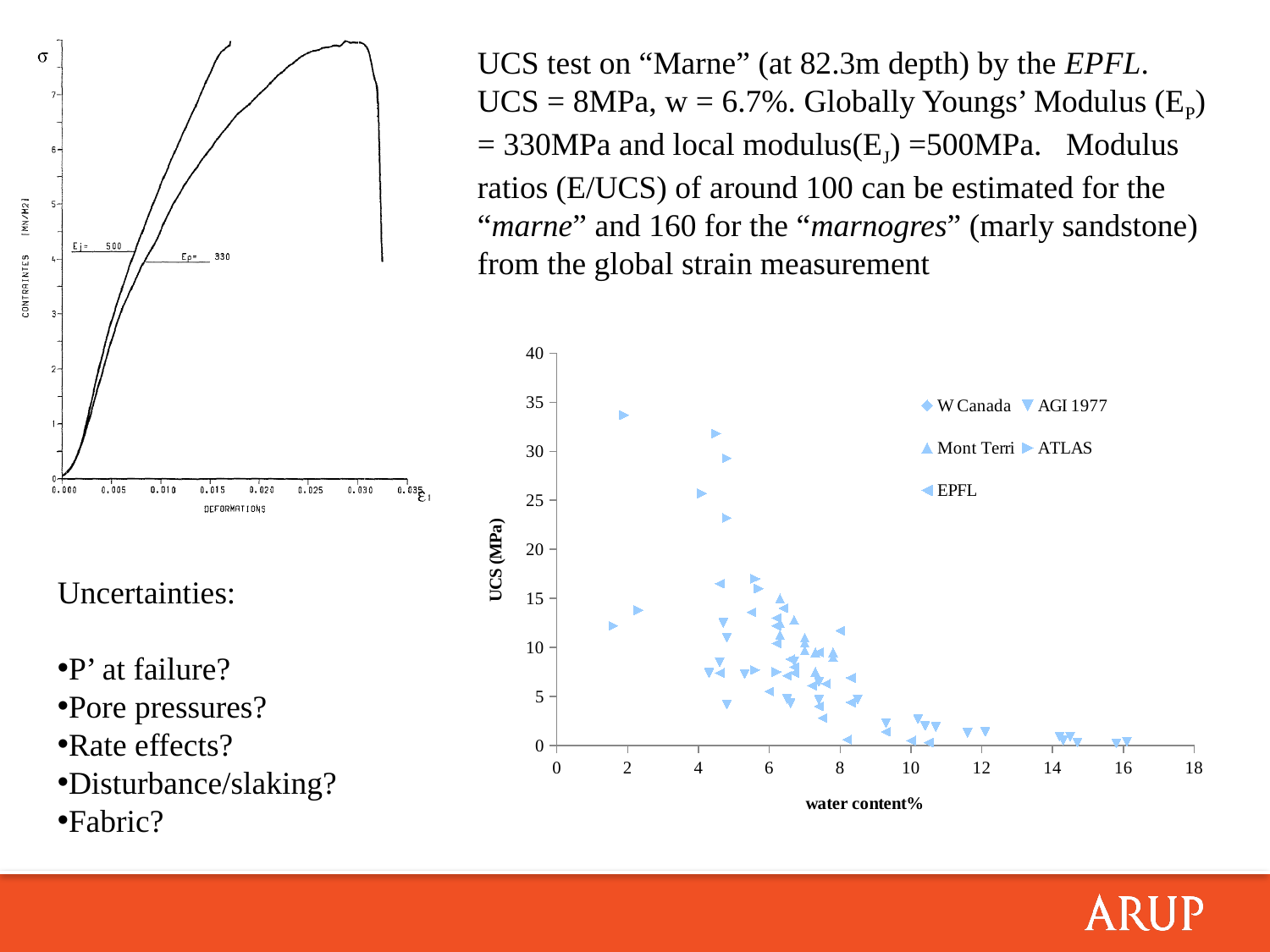
In the UCS versus water content chart, what is the label of the x axis? water content% In the stress-strain chart on the left, what value is labelled for Ej? 500 In the UCS versus water content chart, what is the label of the y axis? UCS (MPa) What kind of chart is the stress-strain chart on the left of the slide? line chart In the UCS versus water content chart, is the highest plotted UCS value greater or less than 30? greater In the UCS versus water content chart, are the points plotted at water content above 14 greater or less than 5 MPa? less In the stress-strain chart on the left, what value is labelled for Ep? 330 In the stress-strain chart on the left, which labelled modulus is larger, Ej or Ep? Ej What kind of chart is the bottom-right chart of UCS against water content? scatter chart In the UCS versus water content chart, what is the maximum value shown on the y axis? 40 In the UCS versus water content chart, do UCS values generally rise or fall as water content increases? fall How many series does the legend of the UCS versus water content chart list? 5